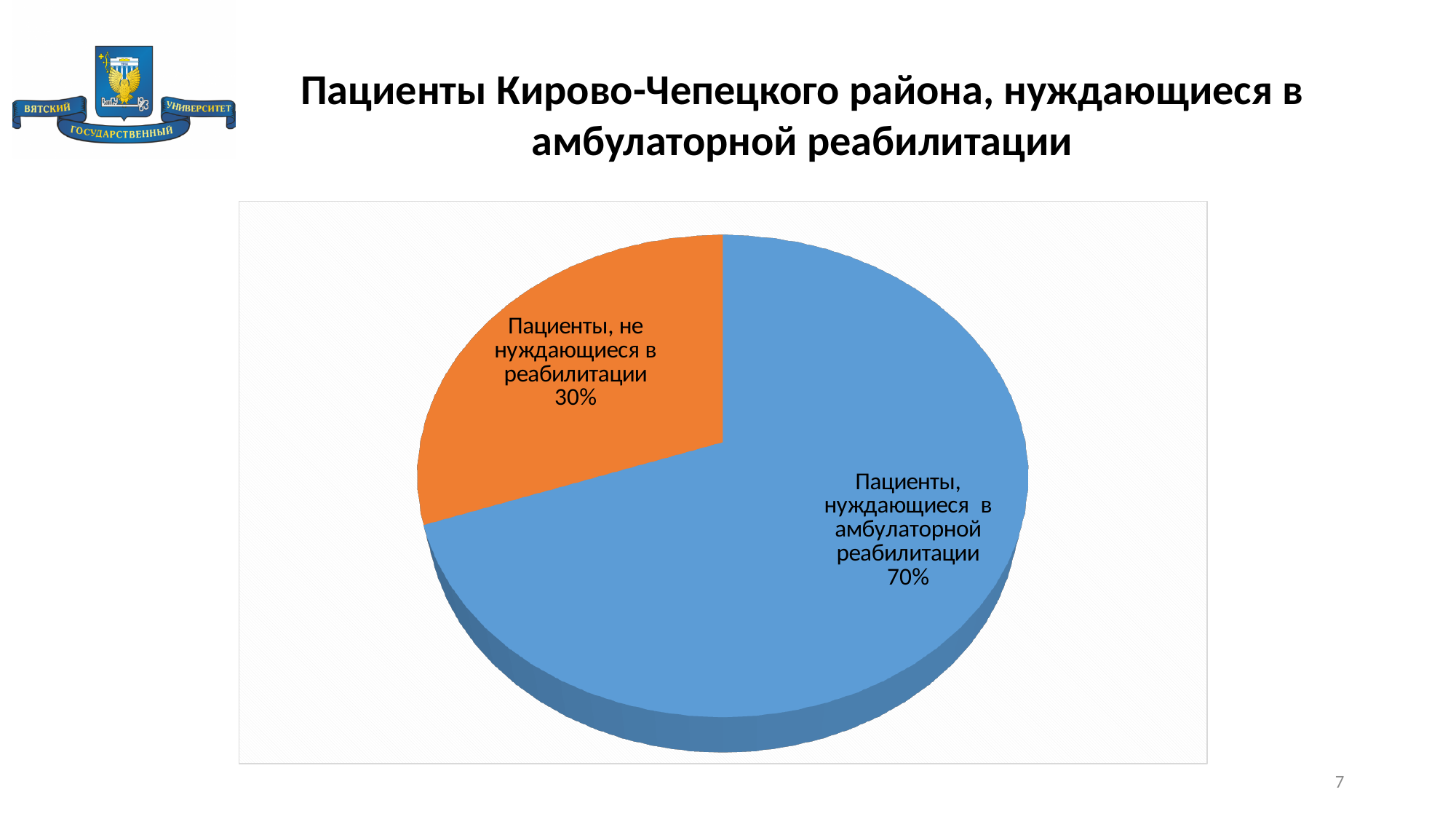
What share of the pie is labelled "Пациенты, не нуждающиеся в реабилитации"? 30% What is the total of the two percentages shown on the pie chart? 100% How many slices does the pie chart have? 2 What is the title of the slide containing the chart? Пациенты Кирово-Чепецкого района, нуждающиеся в амбулаторной реабилитации Is the share of patients needing outpatient rehabilitation greater or less than 50%? greater Which is larger: the share of patients needing outpatient rehabilitation or the share not needing rehabilitation? Пациенты, нуждающиеся в амбулаторной реабилитации What kind of chart is shown on the slide? Pie chart What share of the pie is labelled "Пациенты, нуждающиеся в амбулаторной реабилитации"? 70% Which slice of the pie is the largest? Пациенты, нуждающиеся в амбулаторной реабилитации What is the difference in percentage points between the share of patients needing outpatient rehabilitation and those not needing rehabilitation? 40 percentage points Which slice of the pie is the smallest? Пациенты, не нуждающиеся в реабилитации What colour is the slice for patients not needing rehabilitation? Orange